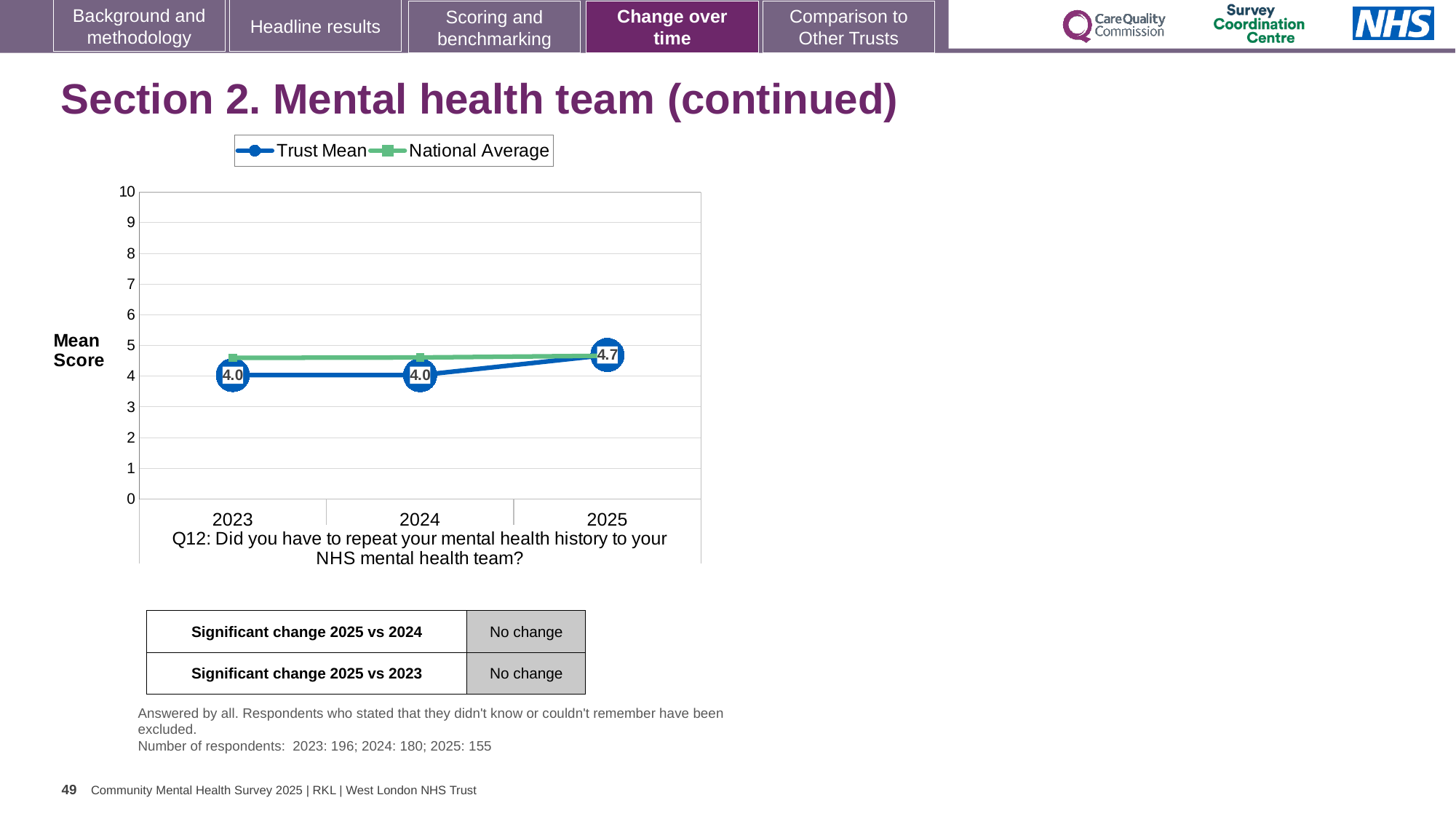
In which year is the Trust Mean highest? 2025 What is the label on the y axis of the chart? Mean Score What kind of chart is shown on the slide? Line chart What is the difference between the Trust Mean in 2025 and in 2024? 0.7 Does the Trust Mean rise or fall from 2024 to 2025? Rise Is the National Average value for 2024 greater or less than 4? greater How many years are plotted on the x axis? 3 What is the Trust Mean value for 2023? 4.0 Is the National Average value for 2023 greater or less than 5? less How many series does the legend list? 2 In 2023, which is larger: the Trust Mean or the National Average? National Average What is the Trust Mean value for 2025? 4.7